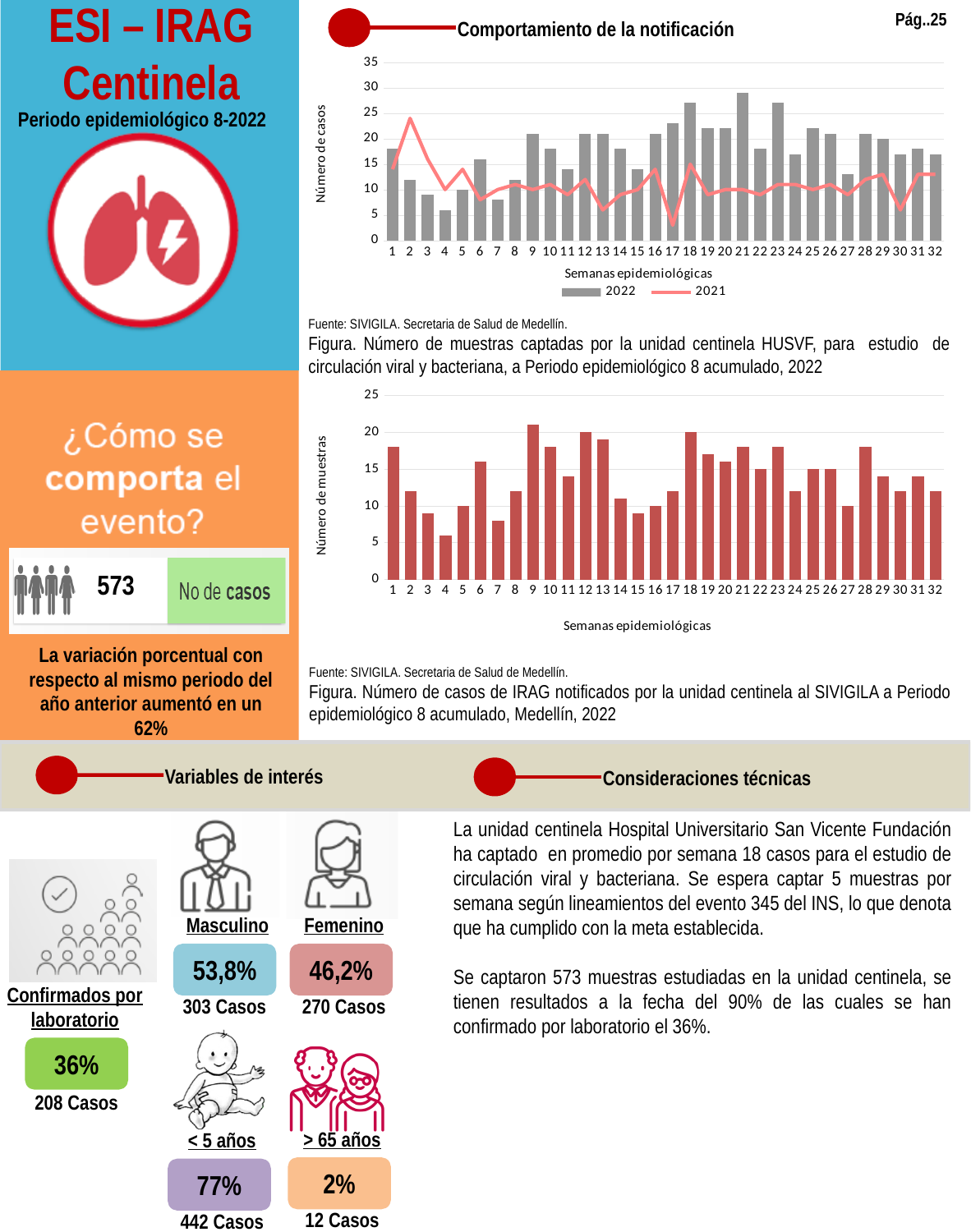
In the bottom chart (Número de muestras), is the value for week 27 greater or less than 15? less In the top chart (Comportamiento de la notificación), which week has the highest 2022 bar? 21 In the bottom chart (Número de muestras), is the value for week 1 greater or less than 15? greater In the top chart (Comportamiento de la notificación), which week has the lowest 2022 bar? 4 In the top chart (Comportamiento de la notificación), how many epidemiological weeks are shown on the x axis? 32 In the bottom chart (Número de muestras), which week has the lowest bar? 4 In the top chart (Comportamiento de la notificación), is the 2022 value for week 4 greater or less than 10? less In the top chart (Comportamiento de la notificación), what are the two legend entries? 2022 and 2021 In the bottom chart (Número de muestras), what kind of chart is it? bar chart In the top chart (Comportamiento de la notificación), how many series does the legend list? 2 In the bottom chart (Número de muestras), which is larger, the value for week 1 or the value for week 4? week 1